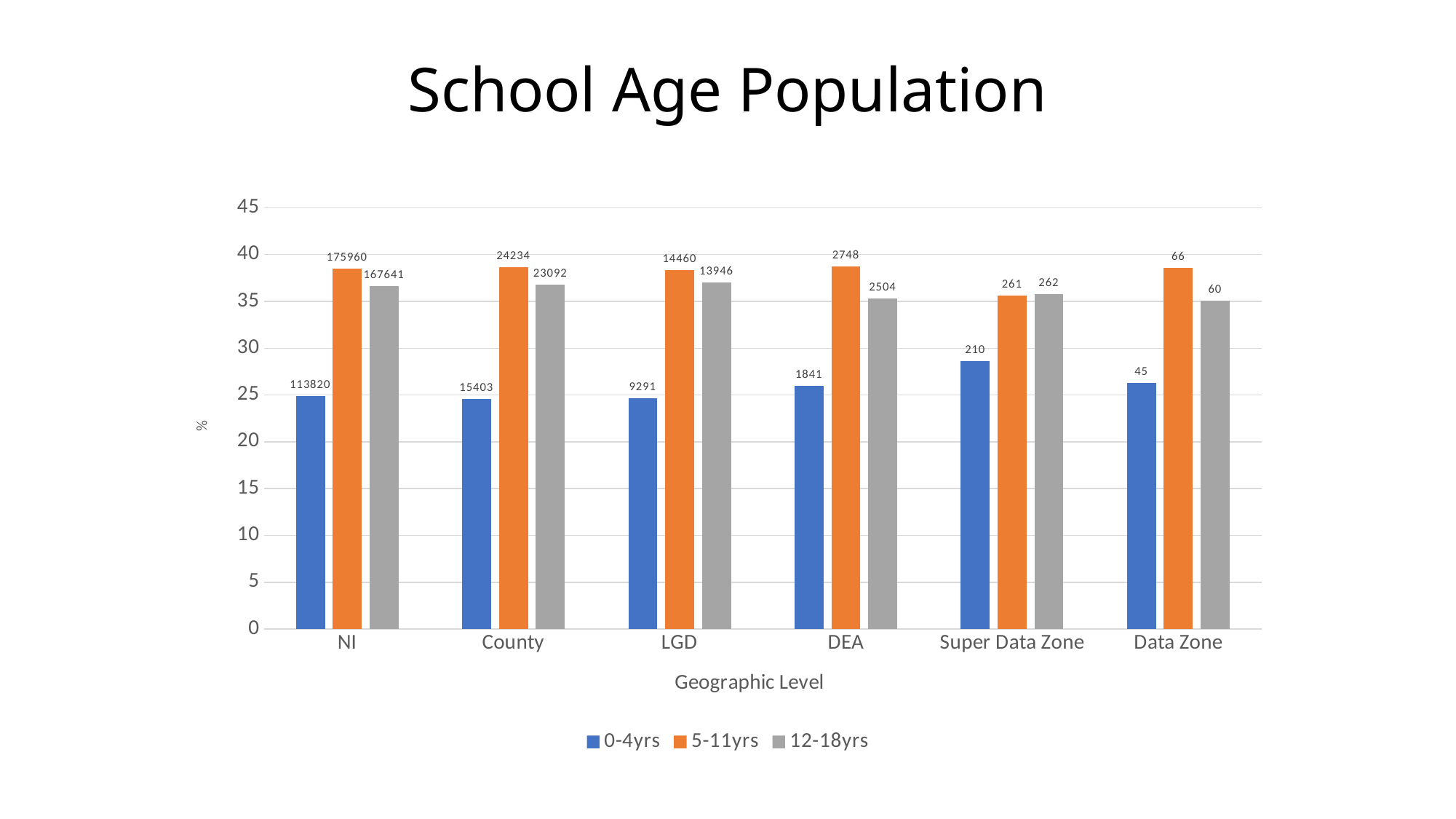
For DEA, which bar is taller: 0-4yrs or 5-11yrs? 5-11yrs How many geographic levels are shown on the x axis? 6 What data label is shown on the 0-4yrs bar for Super Data Zone? 210 What kind of chart is shown on the slide? bar chart What data label is shown on the 0-4yrs bar for NI? 113820 How many series does the legend list? 3 Which geographic level has the tallest 0-4yrs bar? Super Data Zone What data label is shown on the 5-11yrs bar for County? 24234 Is the 5-11yrs bar for NI greater or less than 35 on the y axis? greater What is the title of the x axis? Geographic Level What data label is shown on the 12-18yrs bar for Data Zone? 60 Is the 0-4yrs bar for Super Data Zone greater or less than 30 on the y axis? less